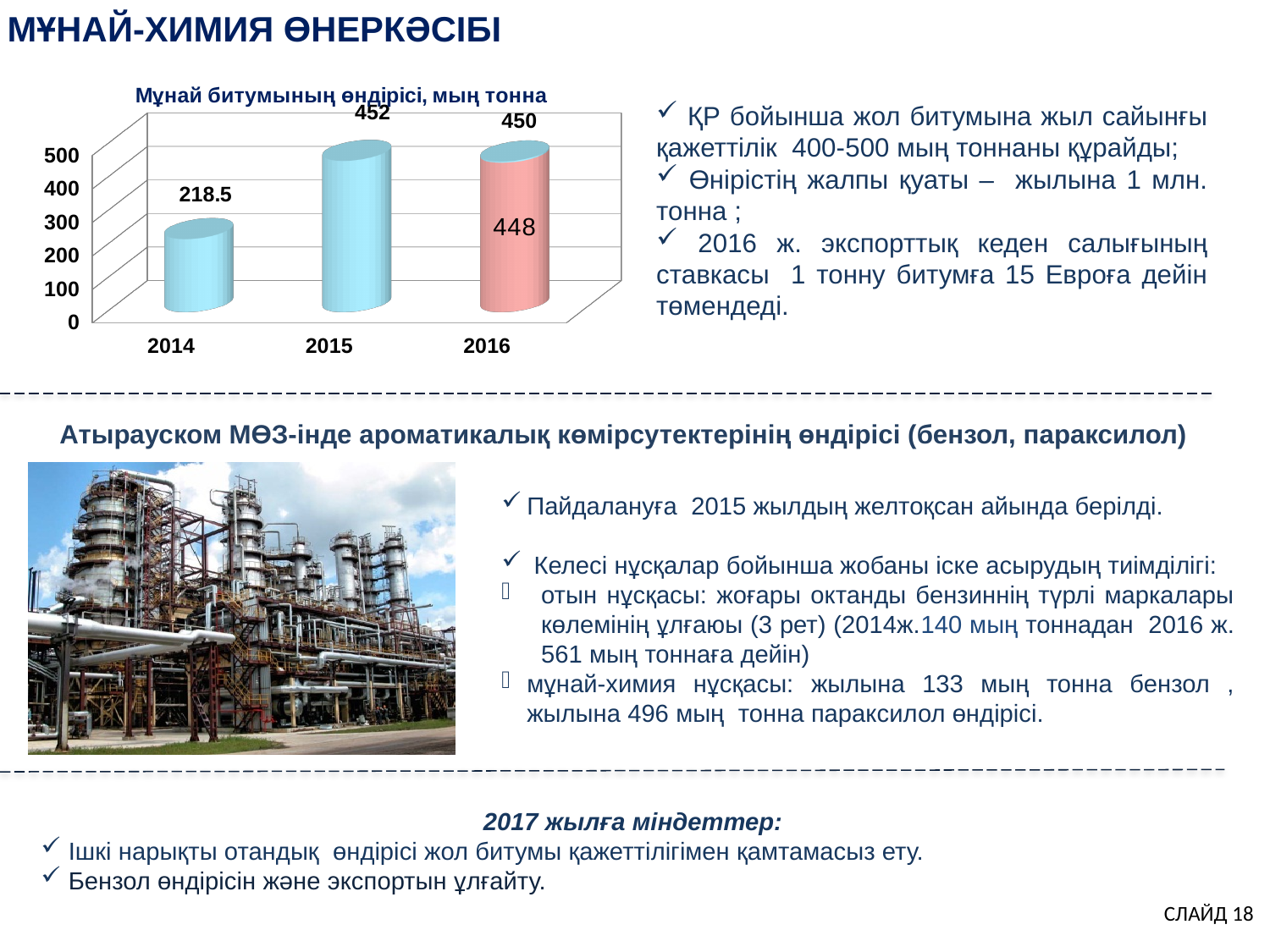
What is the value for 2015 in the chart? 452 What kind of chart is shown on the slide? bar chart What is the title of the chart on the slide? Мұнай битумының өндірісі, мың тонна How many years are shown on the x axis of the chart? 3 What is the difference between the values for 2015 and 2014 in the chart? 233.5 Which year has the lowest value in the chart? 2014 Which is larger in the chart, the value for 2014 or the value for 2016? 2016 Is the value for 2016 greater or less than 400? greater Is the value for 2014 greater or less than 300? less Which year has the highest value in the chart? 2015 Does the value rise or fall from 2014 to 2015 in the chart? rise What is the value for 2014 in the chart? 218.5